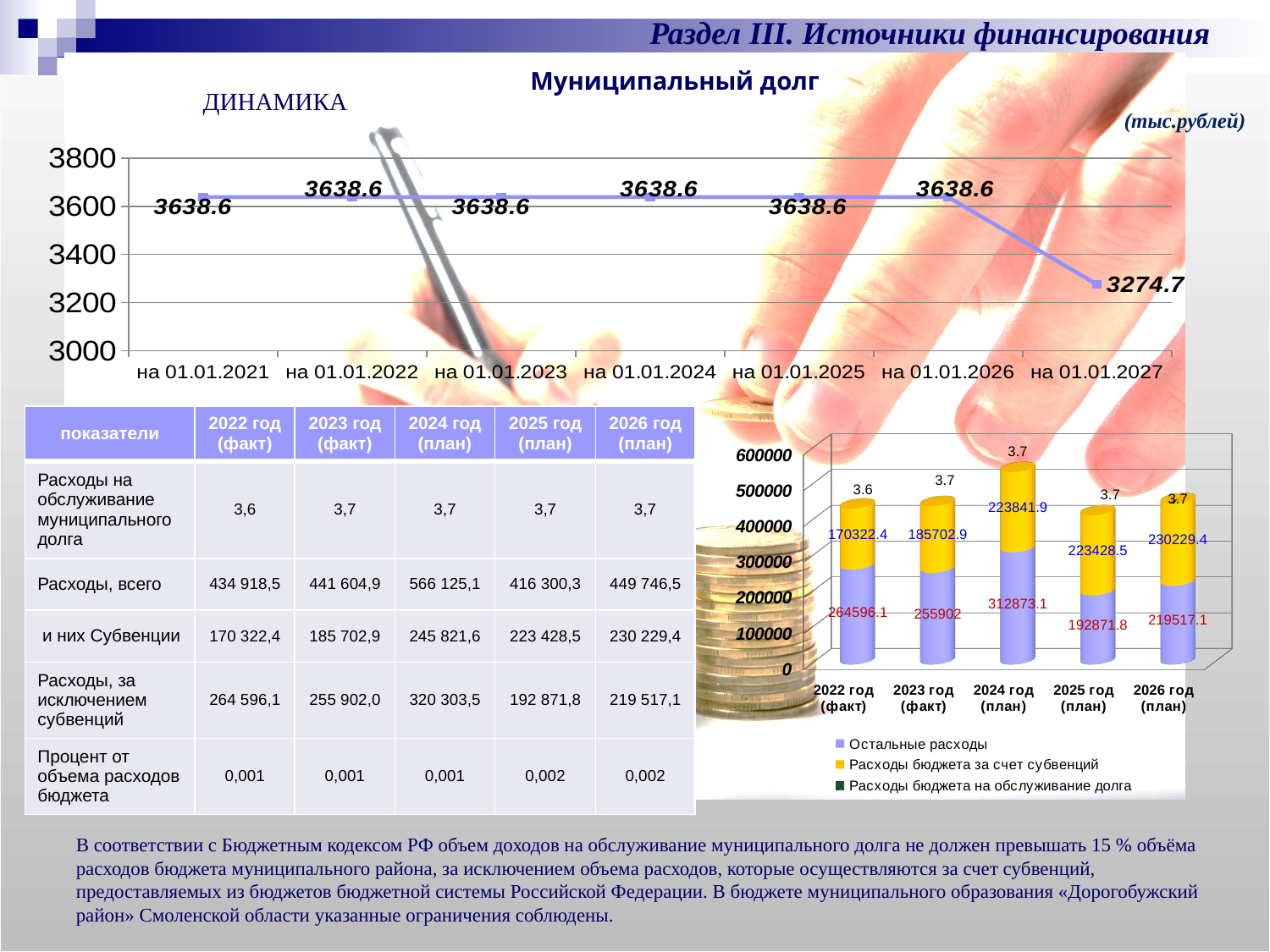
On the bottom-right stacked bar chart, which category has the lowest value for 'Остальные расходы'? 2025 год (план) On the top chart 'Муниципальный долг', what is the difference between the value on 01.01.2026 and the value on 01.01.2027? 363.9 On the bottom-right stacked bar chart, what is the value of 'Расходы бюджета за счет субвенций' for 2026 год (план)? 230229.4 What type of chart is the top chart 'Муниципальный долг'? line chart On the top chart 'Муниципальный долг', which date has the lowest value? на 01.01.2027 On the bottom-right stacked bar chart, what is the value of 'Расходы бюджета на обслуживание долга' for 2022 год (факт)? 3.6 On the top chart 'Муниципальный долг', how many data points are plotted? 7 On the bottom-right stacked bar chart, is the value of 'Остальные расходы' for 2023 год (факт) larger or smaller than for 2024 год (план)? smaller On the bottom-right stacked bar chart, how many series does the legend list? 3 On the top chart 'Муниципальный долг', what is the value on 01.01.2027? 3274.7 On the top chart 'Муниципальный долг', what is the value on 01.01.2021? 3638.6 On the bottom-right stacked bar chart, what is the value of 'Остальные расходы' for 2024 год (план)? 312873.1